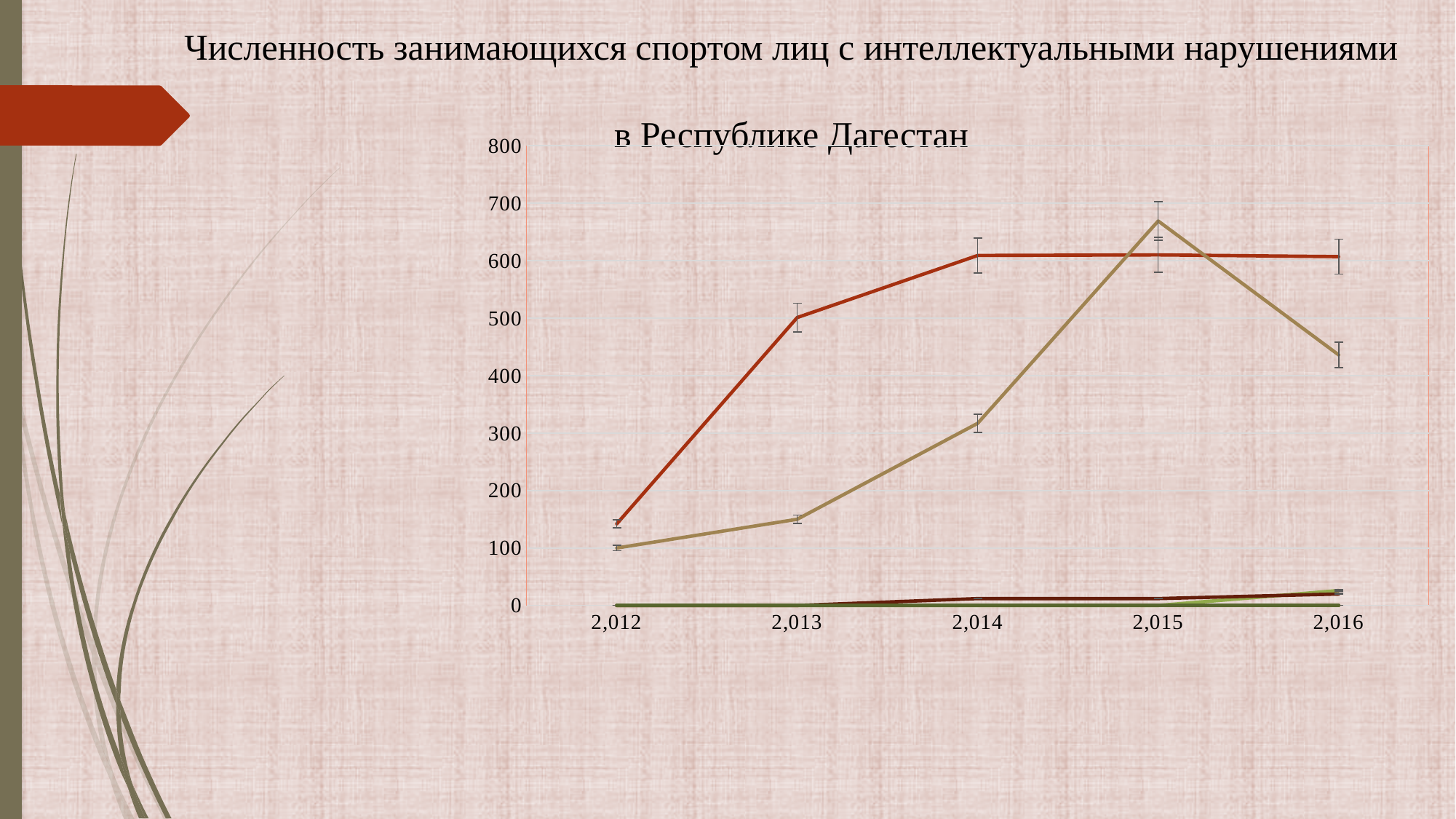
Is the value of the tan line in 2,015 greater or less than 600? greater What is the title of the chart on the slide? Численность занимающихся спортом лиц с интеллектуальными нарушениями в Республике Дагестан Is the value of the tan line in 2,014 greater or less than 400? less In which year does the tan line reach its highest value? 2,015 Is the value of the tan line in 2,016 greater or less than 500? less How many years are shown along the x axis of the chart? 5 In 2,013, which line has the larger value, the red line or the tan line? the red line Does the red line rise or fall between 2,012 and 2,014? rise What kind of chart is shown on the slide? line chart What is the highest value shown on the y axis of the chart? 800